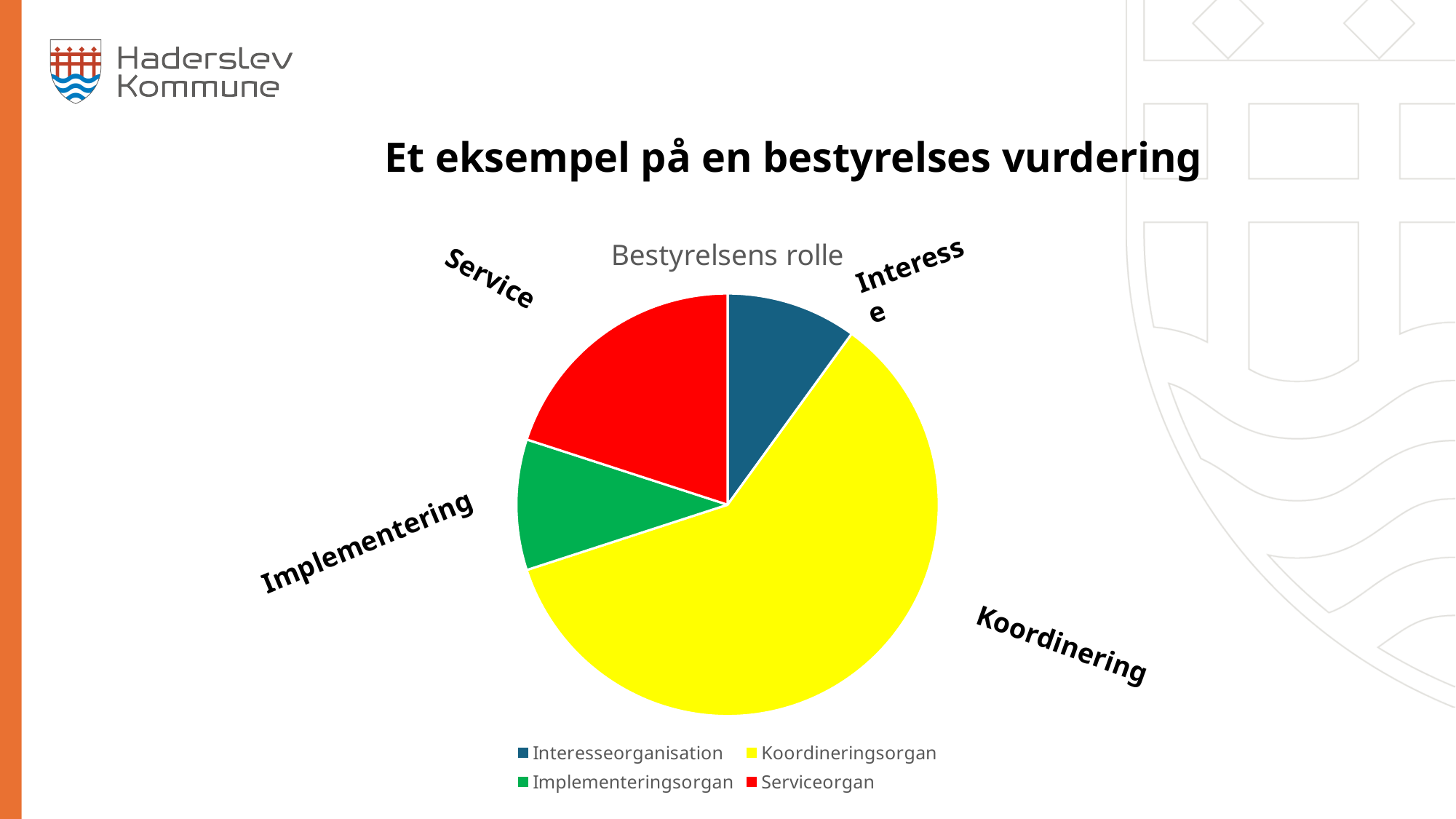
Which is larger, the slice for Serviceorgan or the slice for Implementeringsorgan? Serviceorgan How many entries does the legend list? 4 Which category has the largest slice of the pie? Koordineringsorgan Which is larger, the slice for Koordineringsorgan or the slice for Serviceorgan? Koordineringsorgan Which category is shown in red in the pie chart? Serviceorgan What colour is the slice for Koordineringsorgan? yellow How many slices does the pie chart have? 4 What kind of chart is shown on the slide? pie chart What is the title of the chart? Bestyrelsens rolle Which is larger, the slice for Koordineringsorgan or the slice for Interesseorganisation? Koordineringsorgan